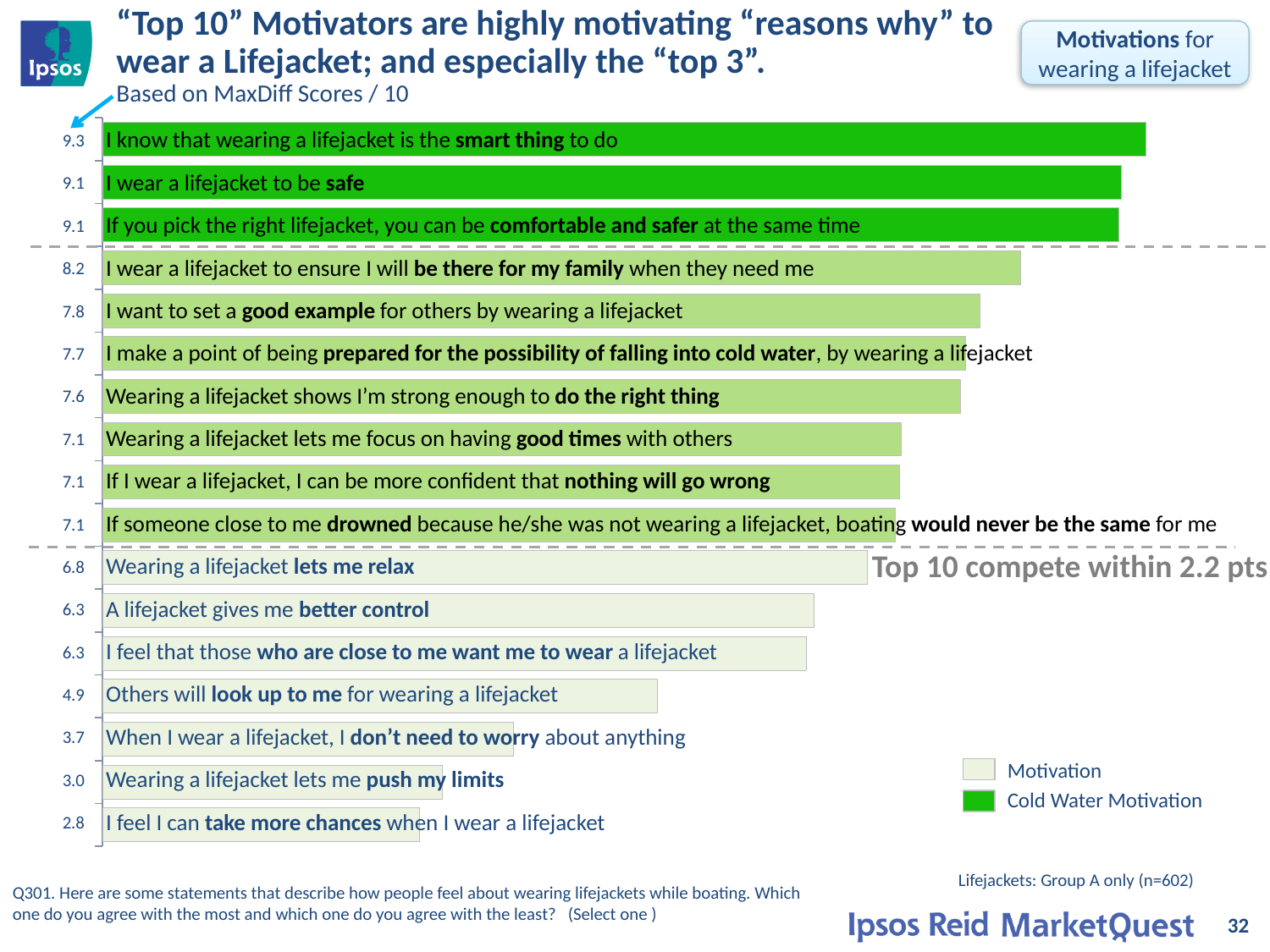
Which statement has the highest MaxDiff score? I know that wearing a lifejacket is the smart thing to do How many statements are plotted in the chart? 17 Which statement has the lowest MaxDiff score? I feel I can take more chances when I wear a lifejacket What is the MaxDiff score for "I wear a lifejacket to ensure I will be there for my family when they need me"? 8.2 Which has a higher score: "Wearing a lifejacket lets me relax" or "Others will look up to me for wearing a lifejacket"? Wearing a lifejacket lets me relax What are the two legend entries in the chart? Motivation and Cold Water Motivation What is the MaxDiff score for "I know that wearing a lifejacket is the smart thing to do"? 9.3 What is the MaxDiff score for "Others will look up to me for wearing a lifejacket"? 4.9 What is the difference between the scores for "be there for my family" (8.2) and "set a good example" (7.8)? 0.4 How many entries does the legend list? 2 What is the difference between the highest score (9.3) and the lowest score (2.8)? 6.5 What kind of chart is shown on the slide? Bar chart